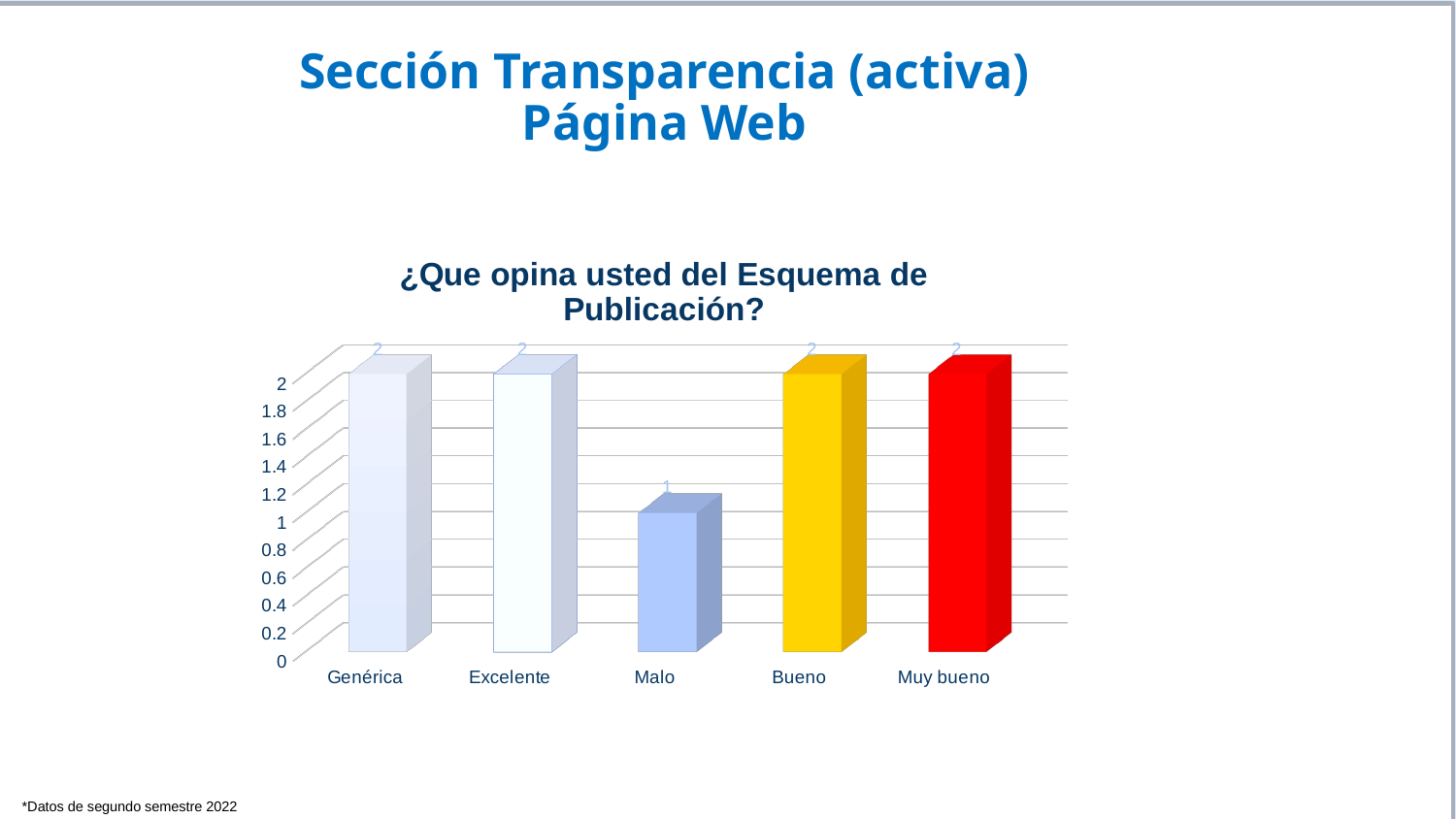
What kind of chart is shown on the slide? bar chart What is the value for Bueno? 2 What is the title of the chart? ¿Que opina usted del Esquema de Publicación? What is the difference between the values for Excelente and Malo? 1 What is the value for Muy bueno? 2 What is the value for Malo? 1 What is the value for Genérica? 2 Which is larger, the value for Bueno or the value for Malo? Bueno What colour is the bar for Muy bueno? red Is the value for Malo greater or less than 1.4? less Which category has the lowest value? Malo How many categories are shown on the x axis? 5